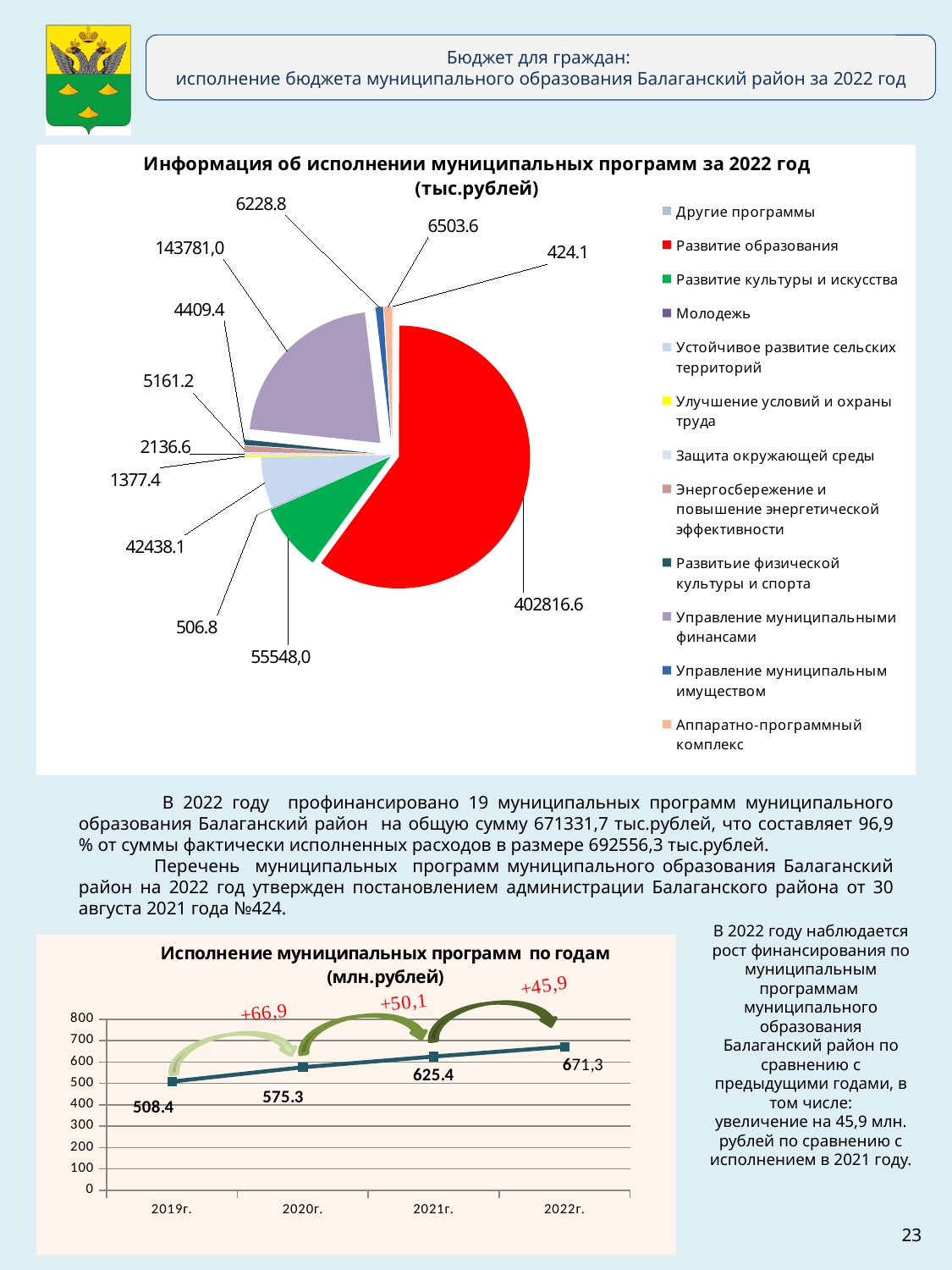
On the chart 'Исполнение муниципальных программ по годам', how many years are plotted? 4 On the chart 'Исполнение муниципальных программ по годам', what is the difference between the values for 2020г. and 2019г.? 66.9 On the chart 'Исполнение муниципальных программ по годам', what is the value for 2021г.? 625.4 On the pie chart 'Информация об исполнении муниципальных программ за 2022 год', how many entries does the legend list? 12 On the pie chart 'Информация об исполнении муниципальных программ за 2022 год', which program has the largest slice? Развитие образования On the pie chart 'Информация об исполнении муниципальных программ за 2022 год', what is the value for 'Развитие культуры и искусства'? 55548,0 What kind of chart is 'Информация об исполнении муниципальных программ за 2022 год'? Pie chart On the chart 'Исполнение муниципальных программ по годам', what is the value for 2019г.? 508.4 On the pie chart 'Информация об исполнении муниципальных программ за 2022 год', what is the value for 'Управление муниципальными финансами'? 143781,0 On the pie chart 'Информация об исполнении муниципальных программ за 2022 год', what is the value for 'Развитие образования'? 402816.6 On the chart 'Исполнение муниципальных программ по годам', do the values rise or fall from 2019г. to 2022г.? Rise On the pie chart 'Информация об исполнении муниципальных программ за 2022 год', which is larger: 'Развитие культуры и искусства' or 'Управление муниципальными финансами'? Управление муниципальными финансами